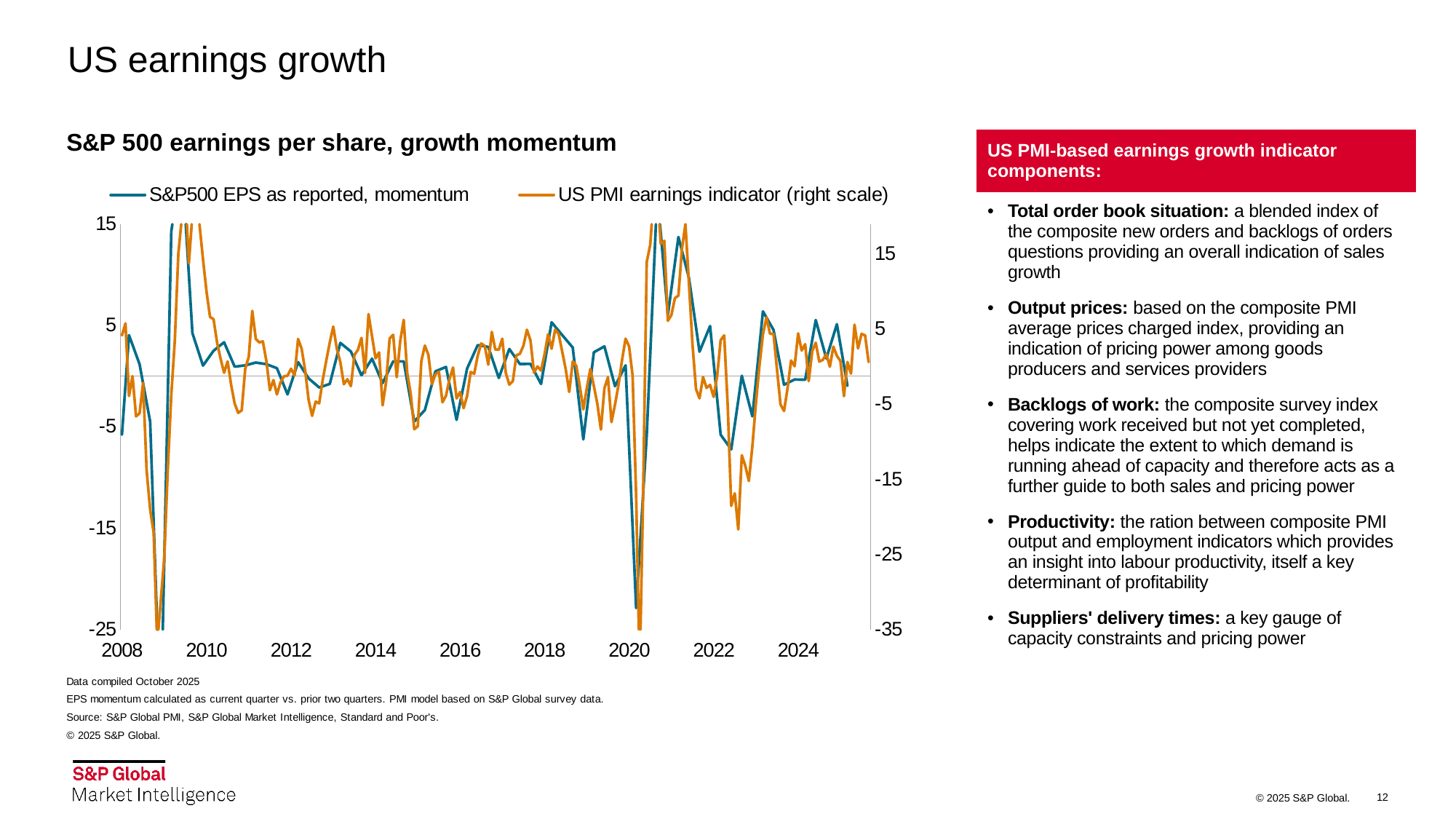
How many series does the chart legend list? 2 What is the lowest value shown on the right-hand axis? -35 What is the lowest value shown on the left-hand axis? -25 How many year labels are shown on the x axis? 9 What is the highest value shown on the left-hand axis? 15 Is the lowest value of the US PMI earnings indicator around 2020 greater or less than -25 on the right scale? less What kind of chart is shown on the slide? Line chart Does the S&P500 EPS momentum line rise or fall between 2008 and early 2009? fall Which series is plotted on the right scale according to the legend? US PMI earnings indicator Is the lowest value of the S&P500 EPS momentum line around 2020 greater or less than -15 on the left scale? less Is the lowest value of the S&P500 EPS momentum line around 2009 greater or less than -15 on the left scale? less What is the title of the chart? S&P 500 earnings per share, growth momentum